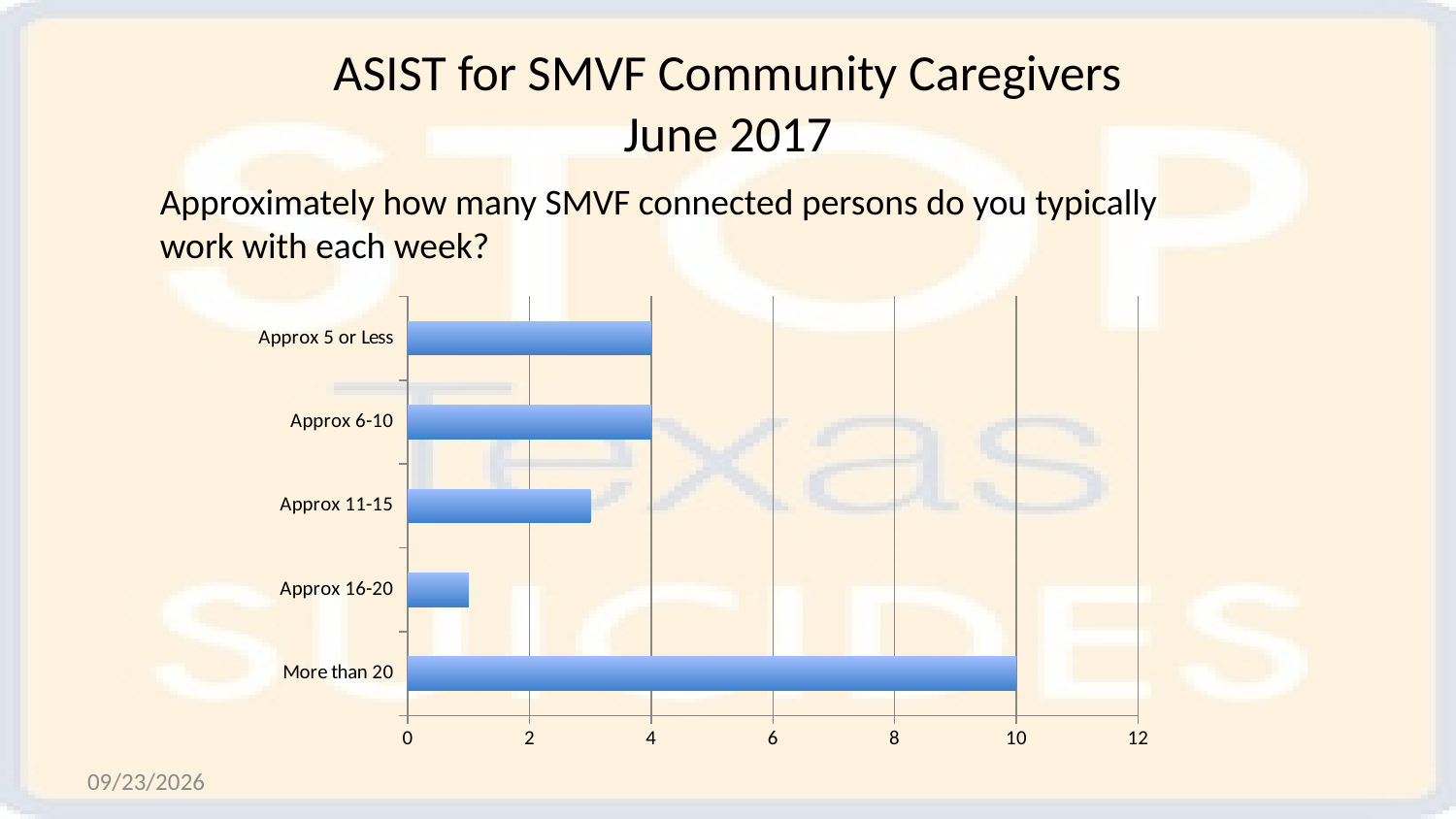
Which category has the lowest value? Approx 16-20 Which category has the highest value? More than 20 Is the value for "Approx 16-20" greater or less than 2? less What is the value for "Approx 6-10"? 4 How many categories does the chart show? 5 What is the difference between the value for "More than 20" and the value for "Approx 5 or Less"? 6 What is the highest tick value shown on the horizontal axis? 12 What kind of chart is shown on the slide? bar chart What is the value for "Approx 5 or Less"? 4 Is the value for "Approx 11-15" greater or less than 2? greater What is the value for "More than 20"? 10 Which is larger, the value for "More than 20" or the value for "Approx 11-15"? More than 20